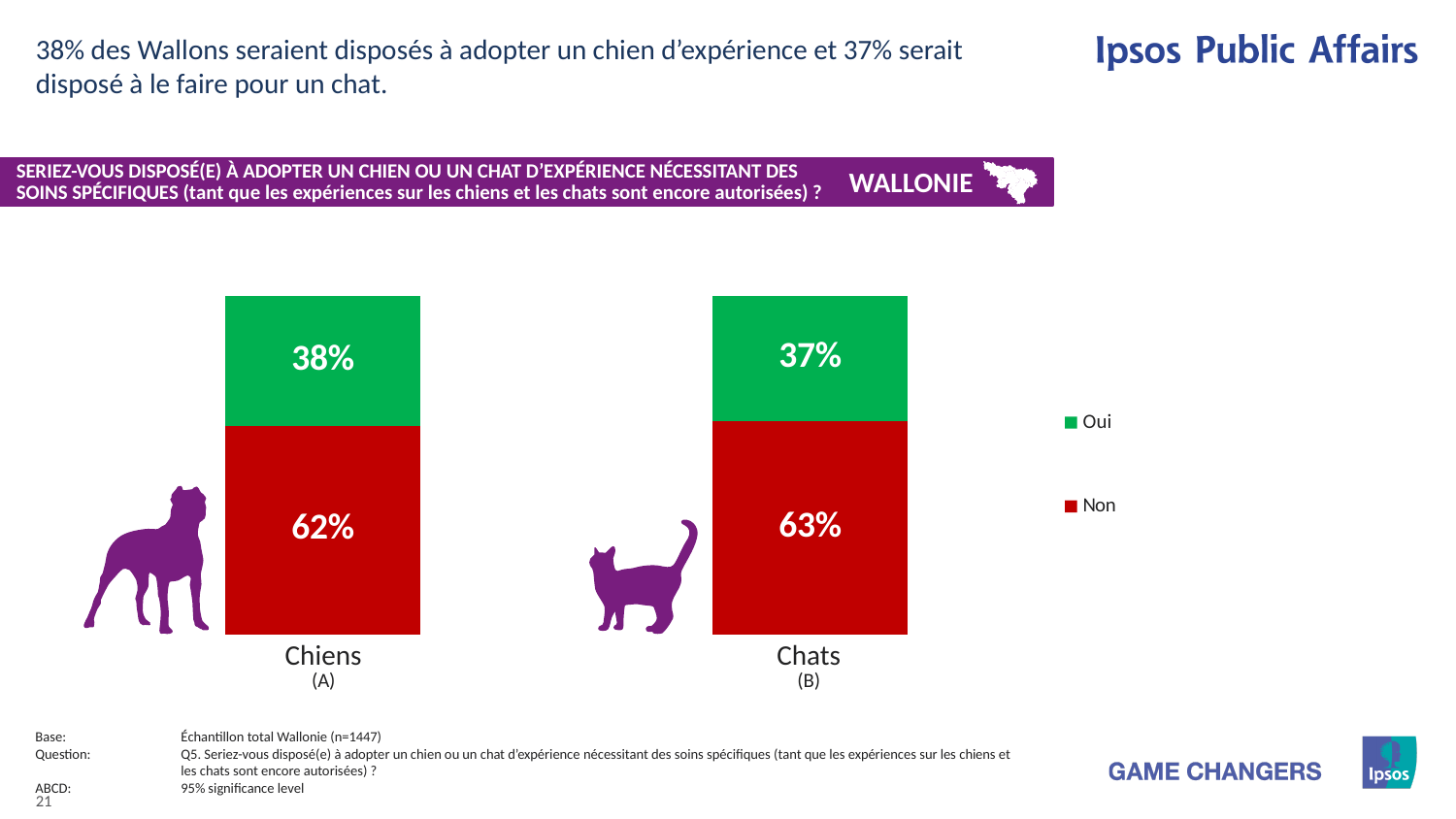
How many series does the legend list? 2 What percentage of respondents answered 'Oui' for Chats? 37% Which category has the higher 'Non' share, Chiens or Chats? Chats What percentage of respondents answered 'Oui' for Chiens? 38% What kind of chart is shown on the slide? Stacked bar chart What percentage of respondents answered 'Non' for Chats? 63% What is the difference between the 'Non' and 'Oui' percentages for Chiens? 24% What is the total of the stacked bar for Chats? 100% Which category has the higher 'Oui' share, Chiens or Chats? Chiens How many categories are shown on the x axis of the chart? 2 What is the difference between the 'Non' and 'Oui' percentages for Chats? 26% What percentage of respondents answered 'Non' for Chiens? 62%